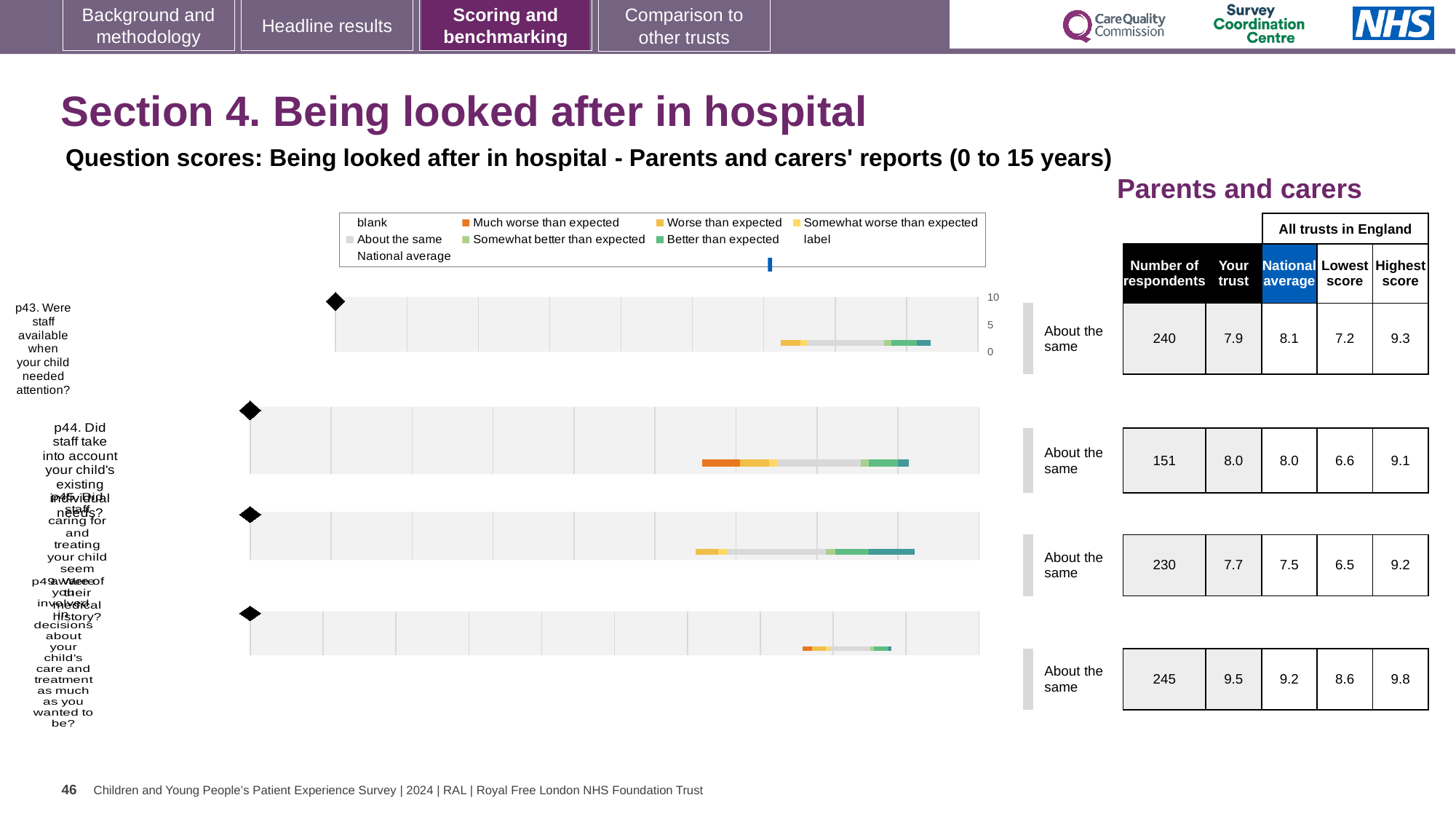
What is the national average score for p44 (Did staff take into account your child's existing individual needs?)? 8.0 What is the 'Your trust' score for p43 (Were staff available when your child needed attention?)? 7.9 For p43, which is larger: the 'Your trust' score or the national average? National average What kind of chart is used to show the benchmarking results on this slide? Bar chart How many survey questions (rows) are plotted on this slide? 4 What is the lowest score among all trusts in England for p44? 6.6 What is the highest score among all trusts in England for p43? 9.3 What benchmark category is shown next to the chart for p43? About the same For p43, what is the difference between the national average and the 'Your trust' score? 0.2 In the table, how many respondents are shown for p43 (Were staff available when your child needed attention?)? 240 Which row of the table has the lowest 'Lowest score' value, and what is it? The third row, 6.5 What is the highest 'Your trust' score shown in the table on this slide? 9.5